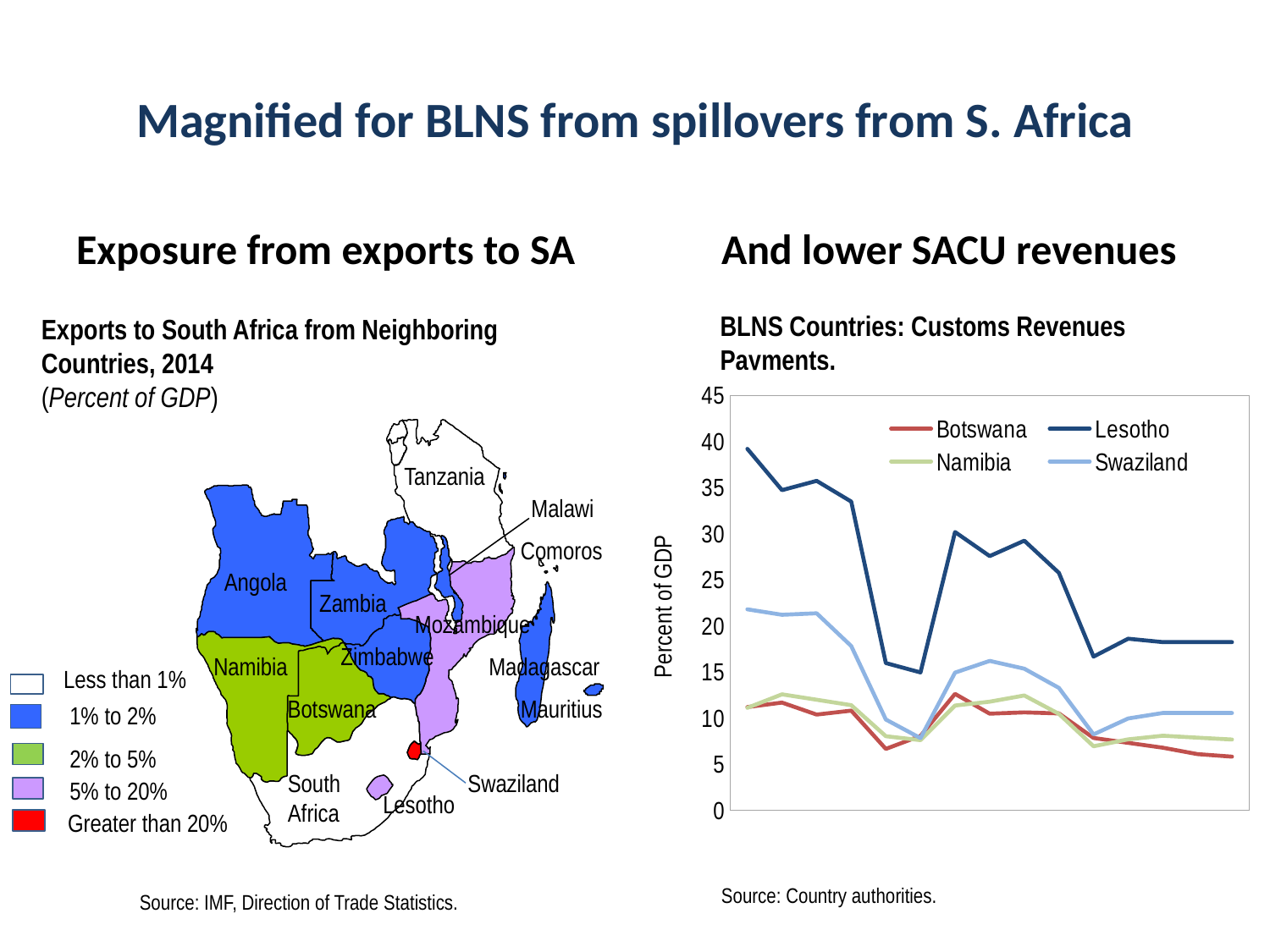
In the 'BLNS Countries: Customs Revenues Payments' chart, is Lesotho's first value greater or less than 35? greater In the 'BLNS Countries: Customs Revenues Payments' chart, which is larger at the start of the series: Lesotho or Botswana? Lesotho In the 'BLNS Countries: Customs Revenues Payments' chart, is Botswana's last value greater or less than 10? less In the 'BLNS Countries: Customs Revenues Payments' chart, which country's line is highest across the whole chart? Lesotho In the 'BLNS Countries: Customs Revenues Payments' chart, which is larger at the end of the series: Swaziland or Botswana? Swaziland How many series does the legend of the 'BLNS Countries: Customs Revenues Payments' chart list? 4 In the 'Exports to South Africa from Neighboring Countries, 2014' map, which legend category is Swaziland shaded in? Greater than 20% In the 'BLNS Countries: Customs Revenues Payments' chart, does Lesotho's line rise or fall overall from its first point to its last point? fall What kind of chart is the 'BLNS Countries: Customs Revenues Payments' chart? line chart What is the y-axis label of the 'BLNS Countries: Customs Revenues Payments' chart? Percent of GDP In the 'BLNS Countries: Customs Revenues Payments' chart, is Lesotho's last value greater or less than 15? greater